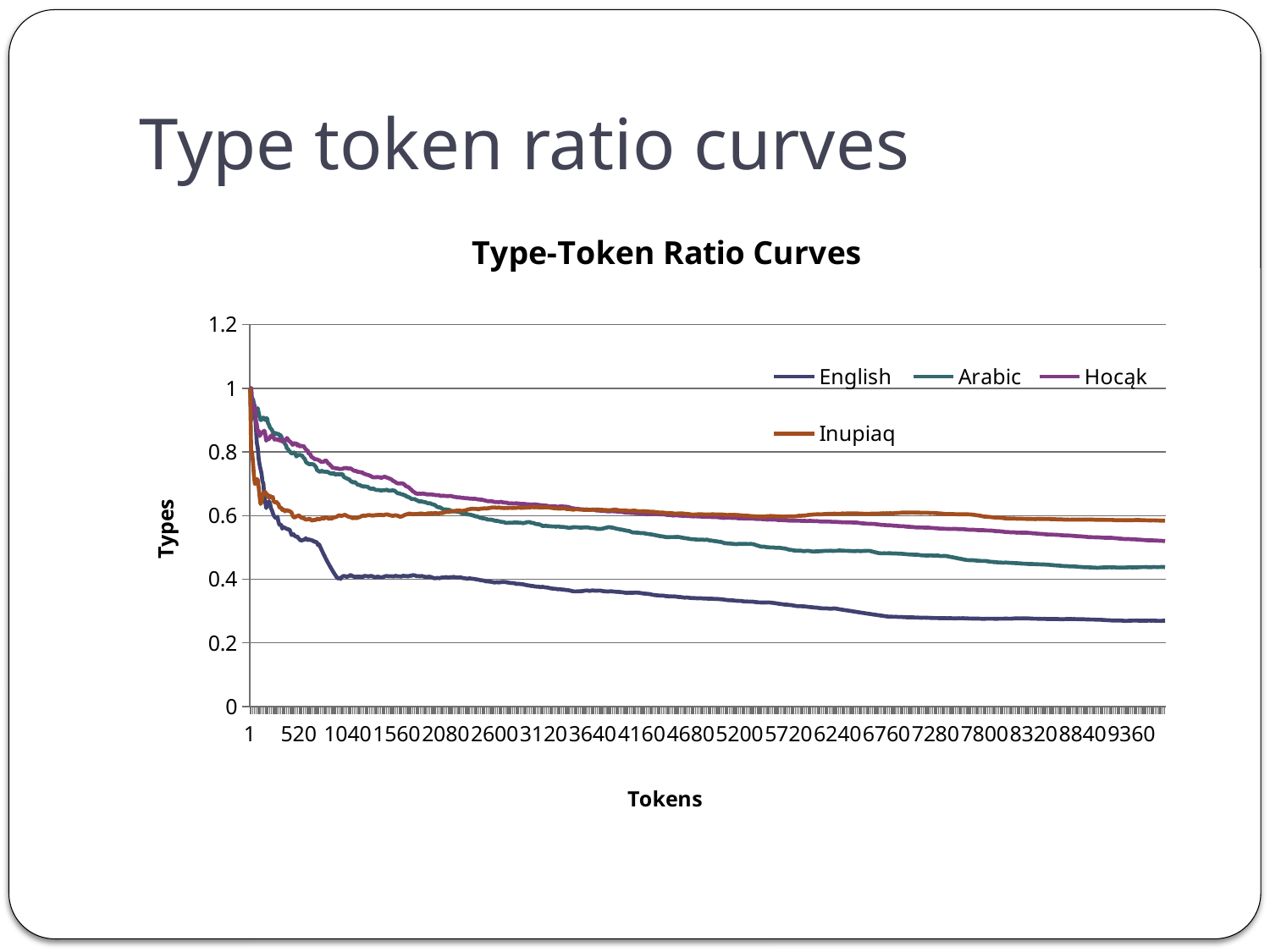
What is the label of the vertical axis? Types At the right end of the x axis, is the value for English greater or less than 0.4? less How many series does the legend list? 4 Which series has the lowest value at the right end of the x axis? English What is the title of the chart? Type-Token Ratio Curves Does the English curve rise or fall as the number of tokens increases? fall Which series has the highest value at the right end of the x axis? Inupiaq At the right end of the x axis, is the value for Hocąk greater or less than 0.6? less At the right end of the x axis, is the value for Arabic greater or less than 0.4? greater What kind of chart is shown on the slide? line chart Does the Hocąk curve rise or fall as the number of tokens increases? fall At the right end of the x axis, which is larger, the value for English or the value for Arabic? Arabic